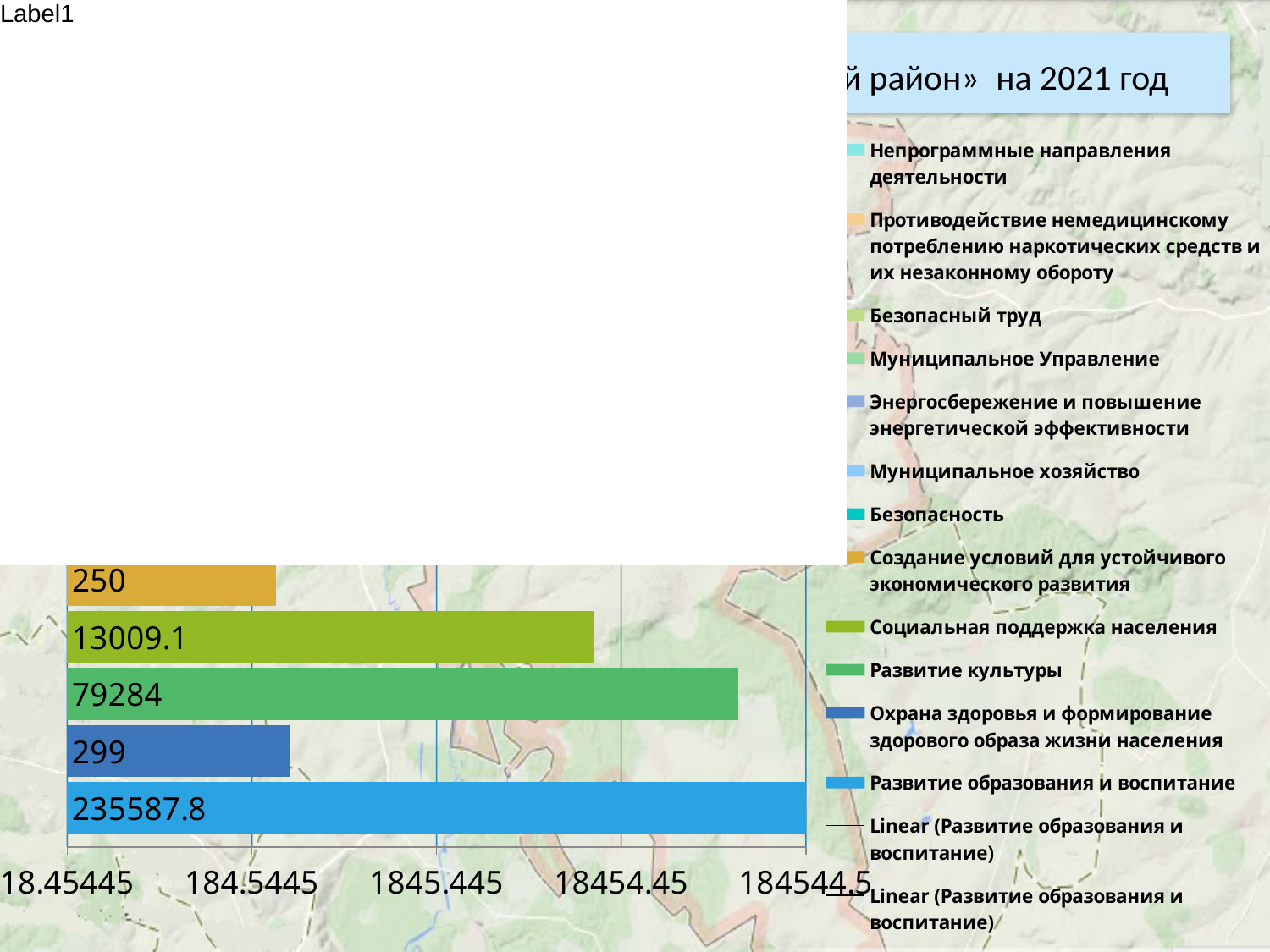
What is the value of the bar for Охрана здоровья и формирование здорового образа жизни населения? 299 What is the largest tick value shown on the horizontal axis? 184544.5 What is the value of the bar for Развитие образования и воспитание? 235587.8 What is the difference between the values for Охрана здоровья и формирование здорового образа жизни населения and Создание условий для устойчивого экономического развития? 49 What is the difference between the values for Развитие культуры and Социальная поддержка населения? 66274.9 What is the value of the bar for Создание условий для устойчивого экономического развития? 250 What kind of chart is shown on the slide? bar chart Which of the visible bars has the lowest value? Создание условий для устойчивого экономического развития What is the value of the bar for Социальная поддержка населения? 13009.1 Which of the visible bars has the highest value? Развитие образования и воспитание Which is larger: the value for Развитие культуры or the value for Социальная поддержка населения? Развитие культуры What is the value of the bar for Развитие культуры? 79284